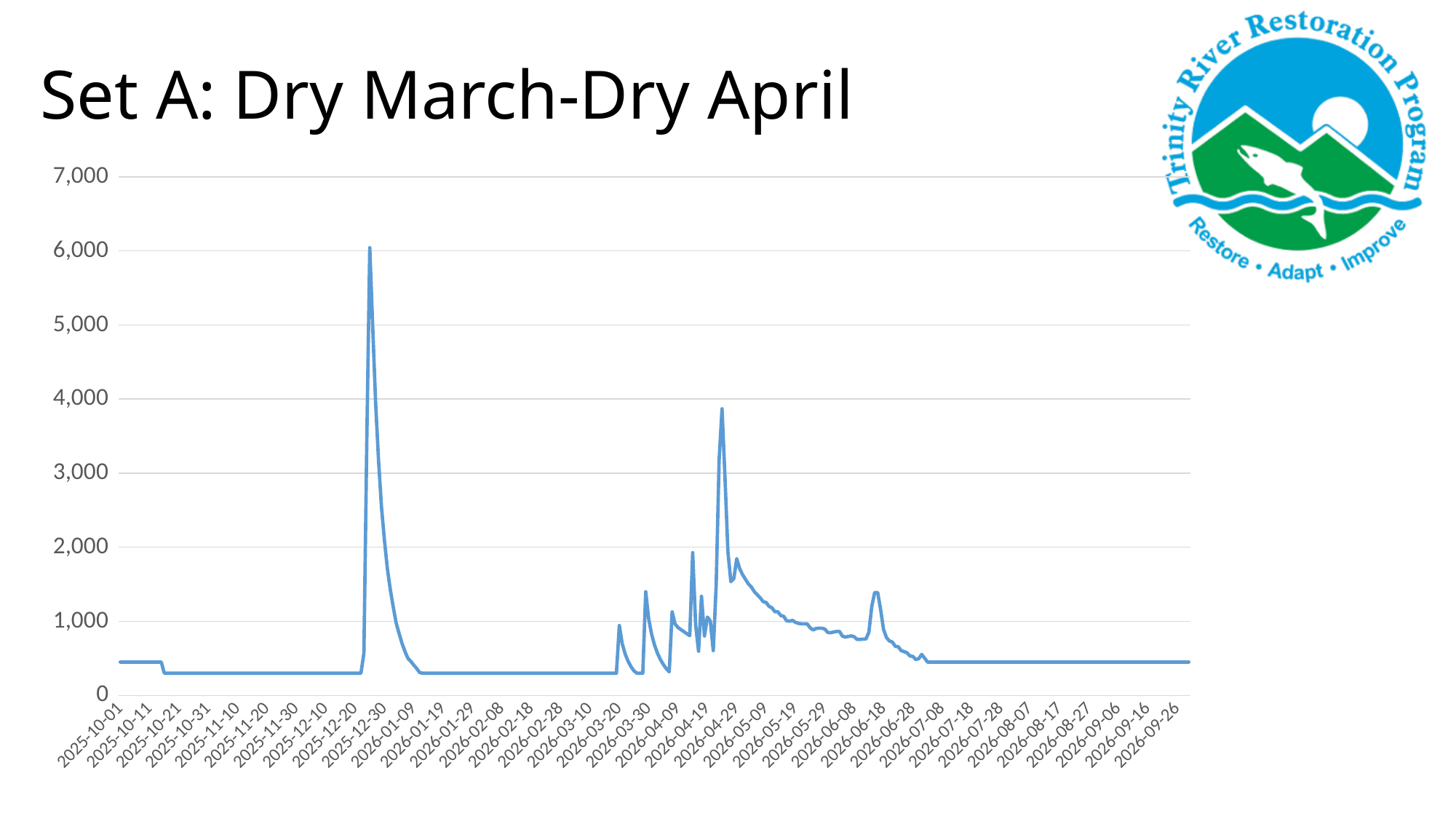
What is the title of the chart on the slide? Set A: Dry March-Dry April Is the value at 2026-08-07 greater or less than 1,000? less Is the value at 2025-11-10 greater or less than 1,000? less Is the peak near 2026-06-18 greater or less than 2,000? less Which is higher: the peak near 2025-12-30 or the peak near 2026-04-29? the peak near 2025-12-30 How many lines are plotted on the chart? 1 Does the line rise or fall between 2026-05-09 and 2026-06-08? fall What kind of chart is shown on the slide? line chart What is the highest tick value shown on the y axis? 7,000 What is the first date label on the x axis? 2025-10-01